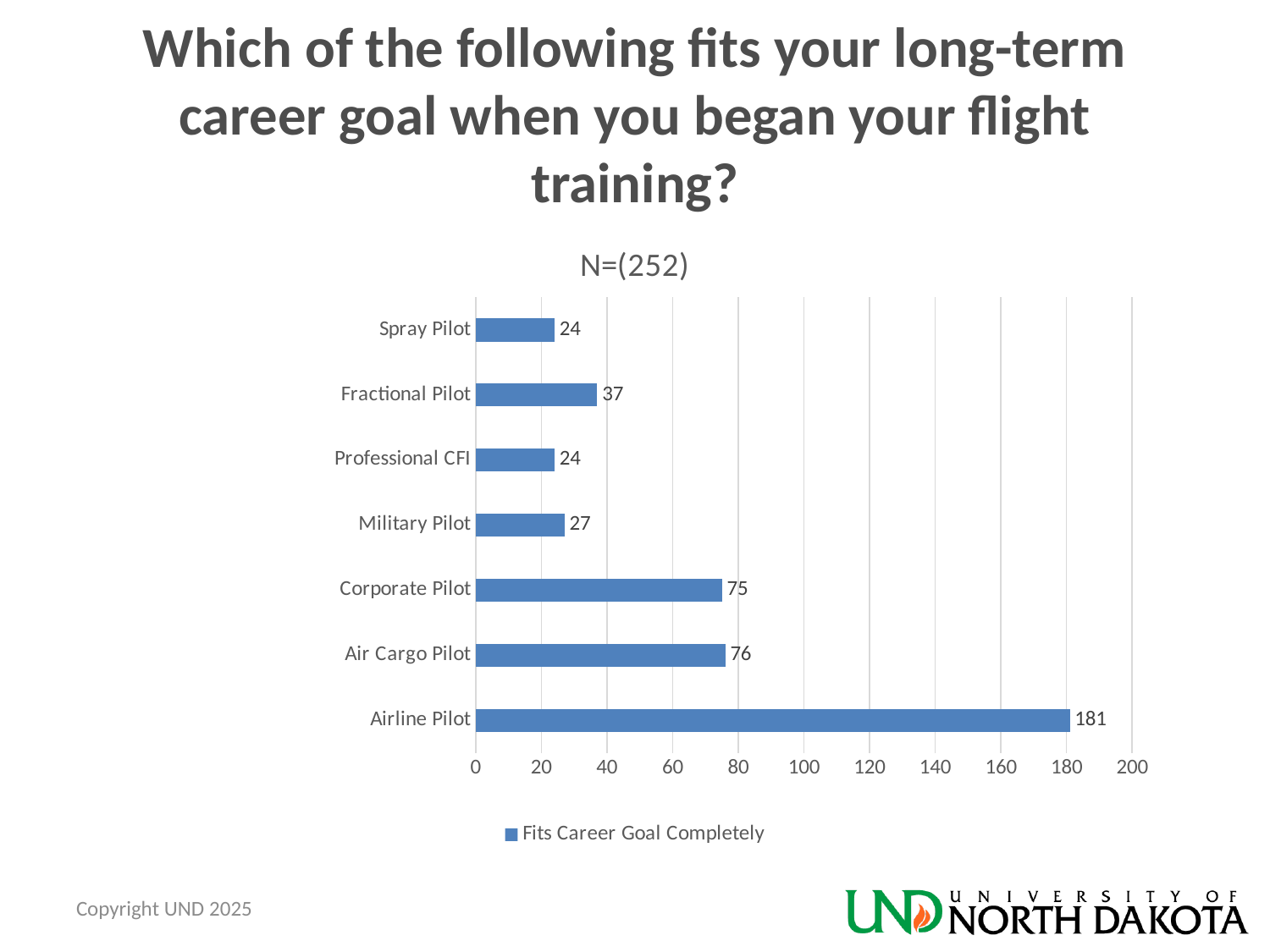
What kind of chart is shown on the slide? Bar chart How many series does the legend list? 1 What is the value for Fractional Pilot? 37 Which is larger, the value for Corporate Pilot or the value for Military Pilot? Corporate Pilot Is the value for Airline Pilot greater or less than 160? greater Which category has the highest value? Airline Pilot What is the chart's title? N=(252) How many categories are shown in the chart? 7 What is the difference between the values for Fractional Pilot and Spray Pilot? 13 What is the difference between the values for Airline Pilot and Air Cargo Pilot? 105 What is the value for Military Pilot? 27 What is the value for Airline Pilot? 181